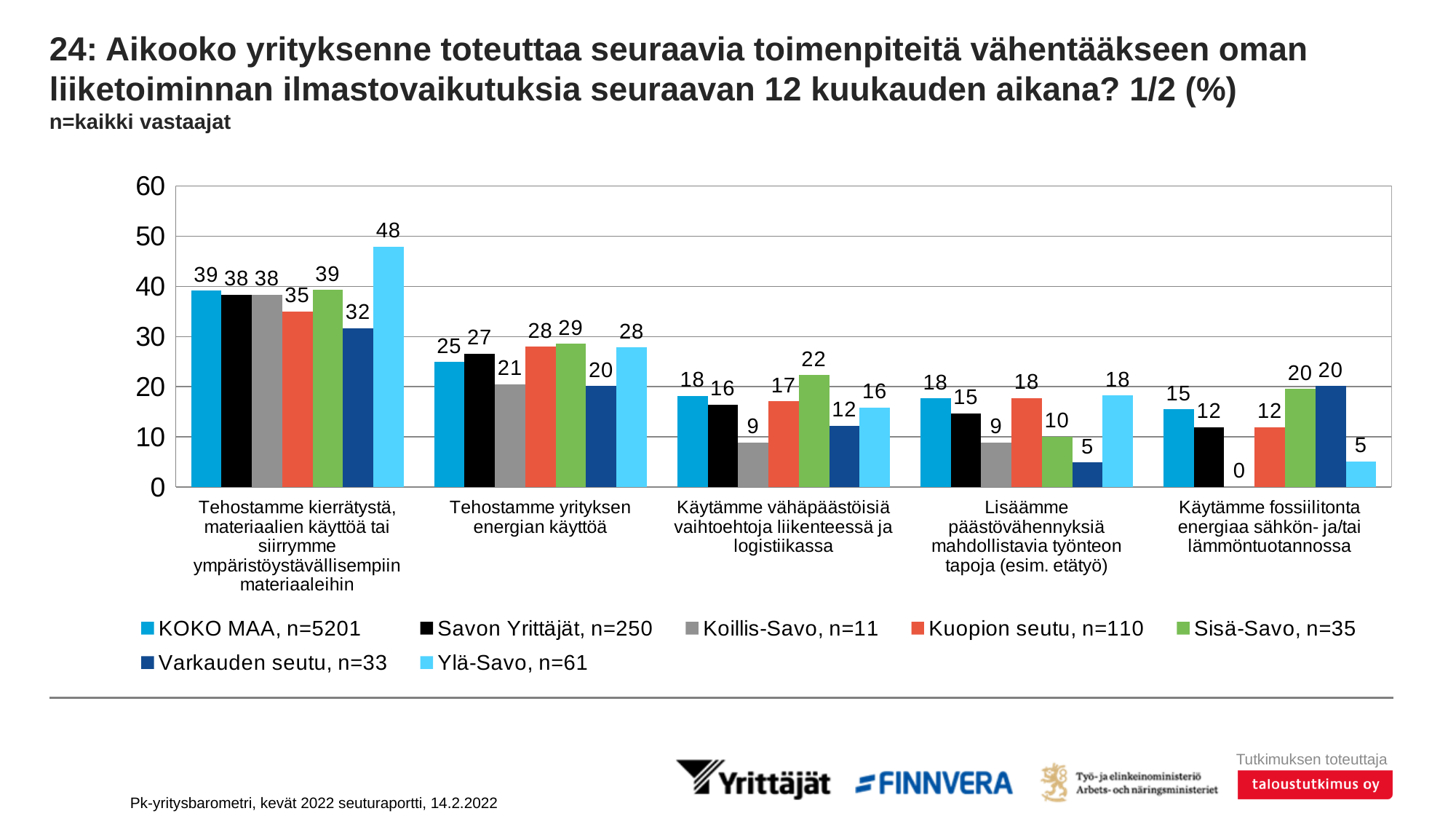
How many series does the legend list? 7 What is the value for Sisä-Savo, n=35 in the category "Käytämme vähäpäästöisiä vaihtoehtoja liikenteessä ja logistiikassa"? 22 Which series has the highest value in the category "Tehostamme kierrätystä, materiaalien käyttöä tai siirrymme ympäristöystävällisempiin materiaaleihin"? Ylä-Savo, n=61 What is the value for Kuopion seutu, n=110 in the category "Tehostamme yrityksen energian käyttöä"? 28 What kind of chart is shown on the slide? bar chart Which series has the lowest value in the category "Lisäämme päästövähennyksiä mahdollistavia työnteon tapoja (esim. etätyö)"? Varkauden seutu, n=33 Is the value for KOKO MAA, n=5201 in the category "Tehostamme yrityksen energian käyttöä" greater or less than 20? greater In the category "Käytämme fossiilitonta energiaa sähkön- ja/tai lämmöntuotannossa", which is larger: the value for Sisä-Savo, n=35 or the value for Ylä-Savo, n=61? Sisä-Savo, n=35 What is the value for Koillis-Savo, n=11 in the category "Käytämme fossiilitonta energiaa sähkön- ja/tai lämmöntuotannossa"? 0 How many categories are shown on the x axis of the chart? 5 What is the value for Ylä-Savo, n=61 in the category "Tehostamme kierrätystä, materiaalien käyttöä tai siirrymme ympäristöystävällisempiin materiaaleihin"? 48 What is the difference between the Ylä-Savo, n=61 value and the Varkauden seutu, n=33 value in the category "Tehostamme kierrätystä, materiaalien käyttöä tai siirrymme ympäristöystävällisempiin materiaaleihin"? 16